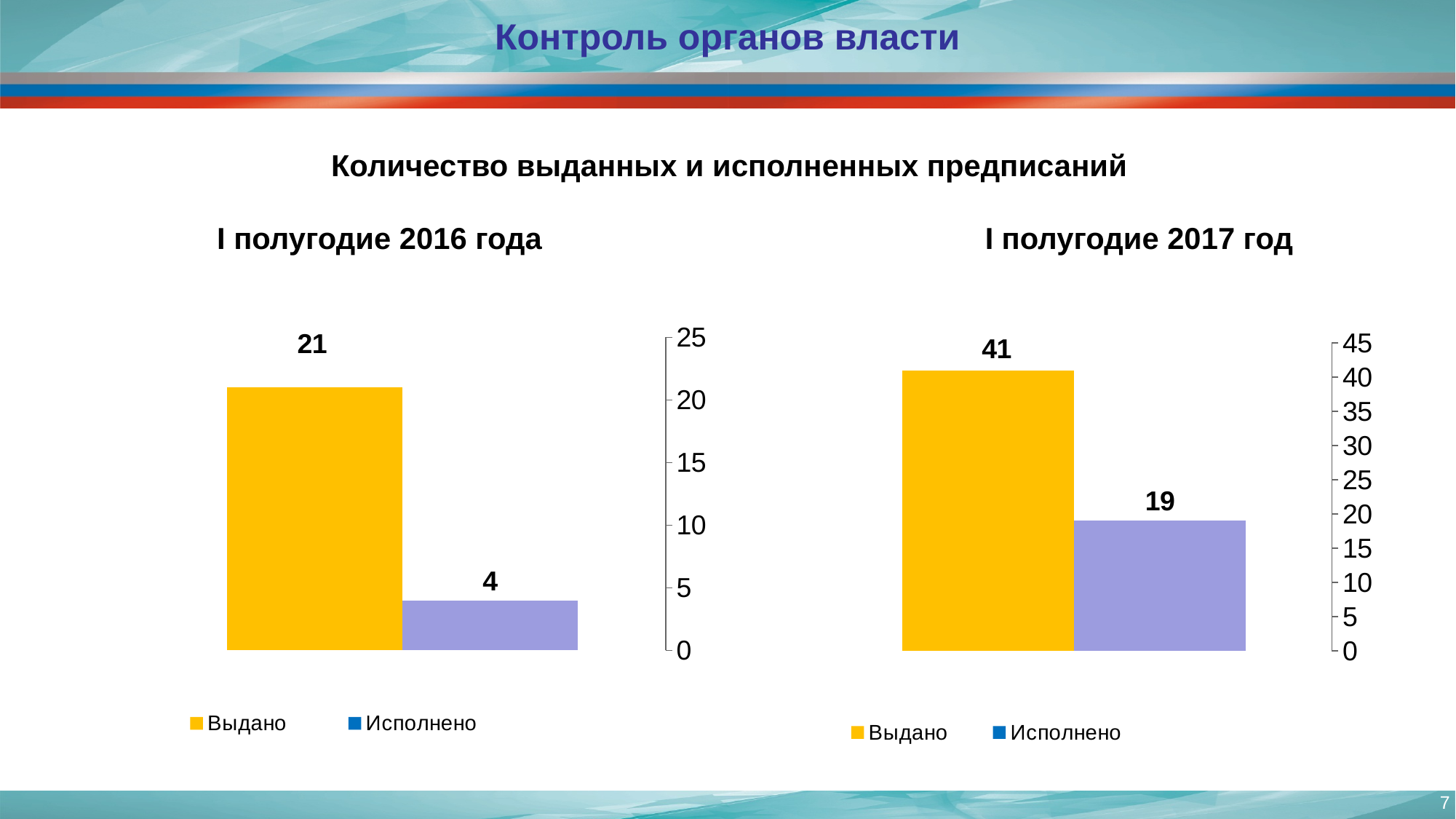
What is the maximum value shown on the vertical axis of the 'I полугодие 2017 год' chart? 45 In the 'I полугодие 2017 год' chart, is the value for Исполнено greater or less than 15? greater In the 'I полугодие 2016 года' chart, which series has the lowest value? Исполнено In the 'I полугодие 2017 год' chart, what is the value for Исполнено? 19 How many series does the legend of the 'I полугодие 2017 год' chart list? 2 In the 'I полугодие 2017 год' chart, what is the difference between Выдано and Исполнено? 22 In the 'I полугодие 2016 года' chart, what is the value for Исполнено? 4 In the 'I полугодие 2016 года' chart, what is the difference between Выдано and Исполнено? 17 What kind of chart is the 'I полугодие 2016 года' chart? Bar chart In the 'I полугодие 2016 года' chart, what is the value for Выдано? 21 In the 'I полугодие 2017 год' chart, what is the value for Выдано? 41 In the 'I полугодие 2017 год' chart, which series has the higher value, Выдано or Исполнено? Выдано